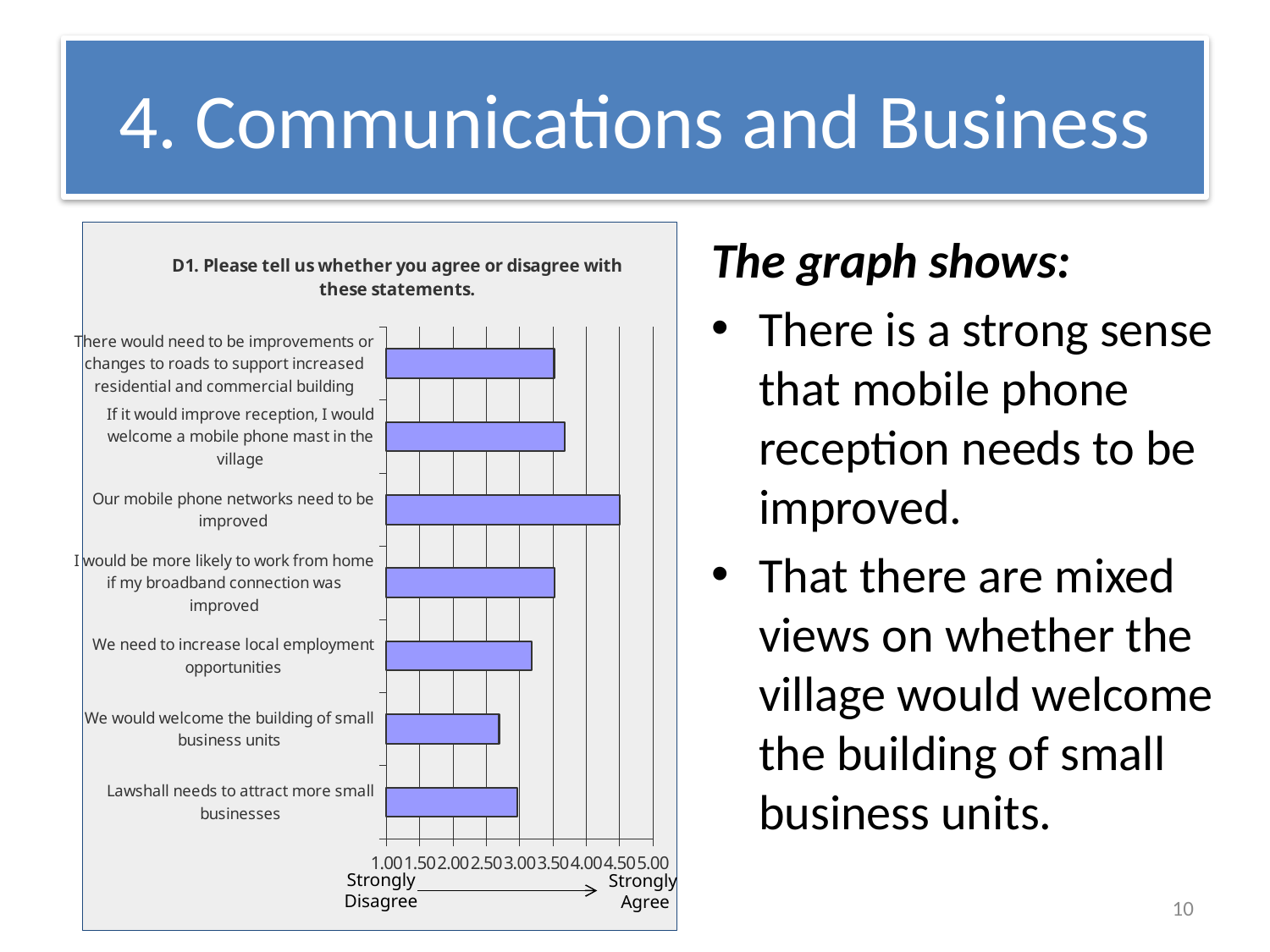
What do the two ends of the chart's horizontal axis represent? Strongly Disagree (1.00) to Strongly Agree (5.00) Is the value for "Our mobile phone networks need to be improved" greater or less than 4.00? greater Which has a higher value: "Our mobile phone networks need to be improved" or "We need to increase local employment opportunities"? Our mobile phone networks need to be improved Is the value for "If it would improve reception, I would welcome a mobile phone mast in the village" greater or less than 3.50? greater Is the value for "We need to increase local employment opportunities" greater or less than 3.00? greater What is the title of the chart? D1. Please tell us whether you agree or disagree with these statements. What kind of chart is shown on the slide? bar chart Which statement has the highest level of agreement in the chart? Our mobile phone networks need to be improved Which statement has the lowest level of agreement in the chart? We would welcome the building of small business units How many statements (categories) are plotted in the chart? 7